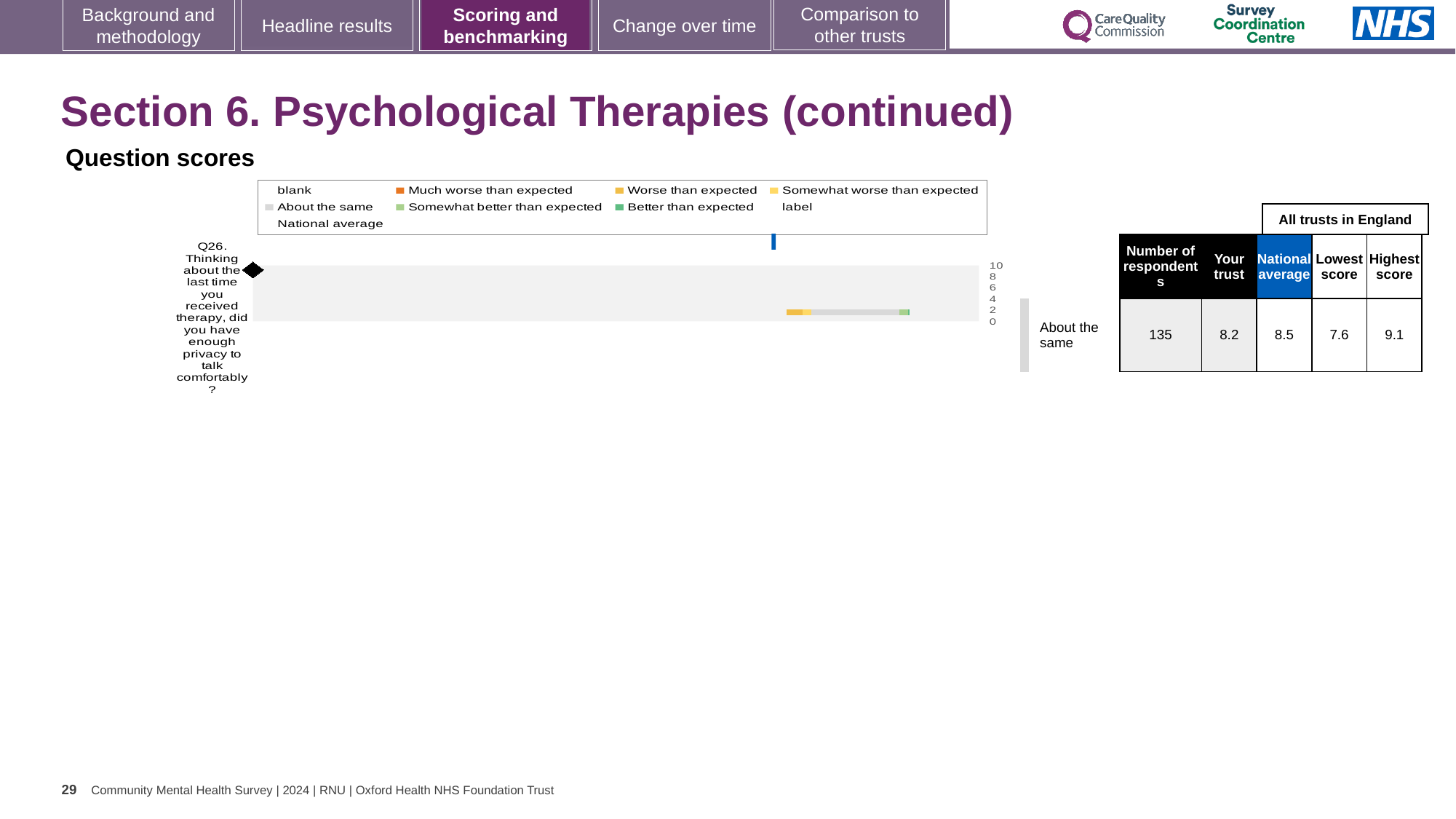
What is the lowest score among all trusts in England for Q26? 7.6 What is the 'Your trust' score for Q26 in the table beside the chart? 8.2 How many respondents answered Q26 according to the table beside the chart? 135 What is the difference between the national average and the 'Your trust' score for Q26? 0.3 Which question is plotted in the chart? Q26. Thinking about the last time you received therapy, did you have enough privacy to talk comfortably? What is the national average score for Q26 in the table beside the chart? 8.5 What is the highest value shown on the chart's axis? 10 How many questions (categories) are plotted in the chart? 1 What is the highest score among all trusts in England for Q26? 9.1 What kind of chart is shown under 'Question scores'? bar chart Which is larger for Q26, the 'Your trust' score or the national average? National average What benchmark category is given for Q26 next to the chart? About the same